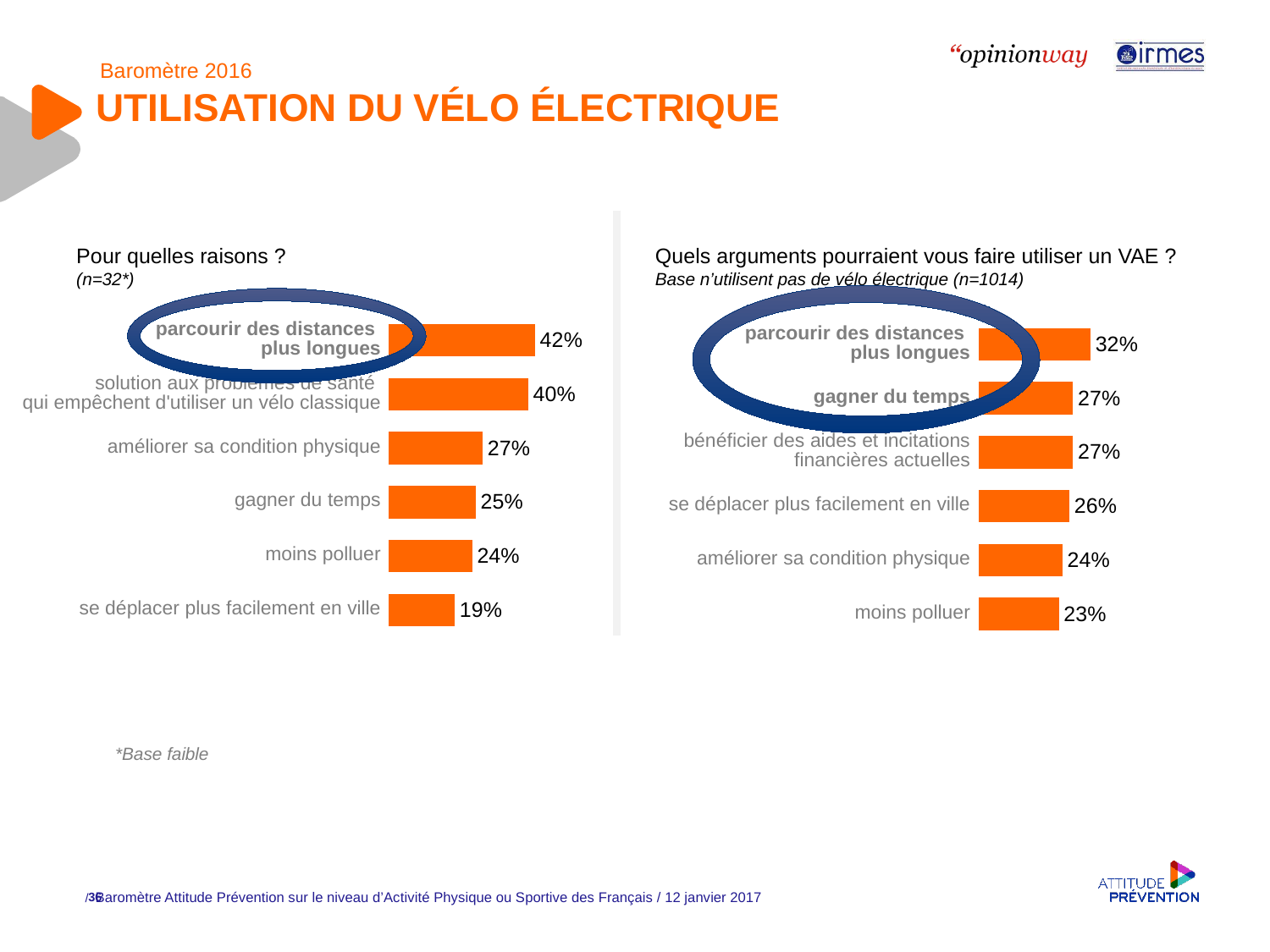
In the left chart ("Pour quelles raisons ?"), which category has the lowest value? se déplacer plus facilement en ville In the right chart ("Quels arguments pourraient vous faire utiliser un VAE ?"), which category has the lowest value? moins polluer In the right chart ("Quels arguments pourraient vous faire utiliser un VAE ?"), what is the value for "parcourir des distances plus longues"? 32% In the left chart ("Pour quelles raisons ?"), how many categories are shown? 6 In the left chart ("Pour quelles raisons ?"), what is the value for "gagner du temps"? 25% In the right chart ("Quels arguments pourraient vous faire utiliser un VAE ?"), which category has the highest value? parcourir des distances plus longues In the left chart ("Pour quelles raisons ?"), what is the difference between "parcourir des distances plus longues" and "moins polluer"? 18 percentage points Which is larger: "améliorer sa condition physique" in the left chart or "améliorer sa condition physique" in the right chart? the left chart (27%) In the right chart ("Quels arguments pourraient vous faire utiliser un VAE ?"), what is the value for "se déplacer plus facilement en ville"? 26% What type of chart is used on the left side of the slide ("Pour quelles raisons ?")? bar chart In the left chart ("Pour quelles raisons ?"), what is the value for "parcourir des distances plus longues"? 42% In the right chart ("Quels arguments pourraient vous faire utiliser un VAE ?"), what is the difference between "parcourir des distances plus longues" and "gagner du temps"? 5 percentage points